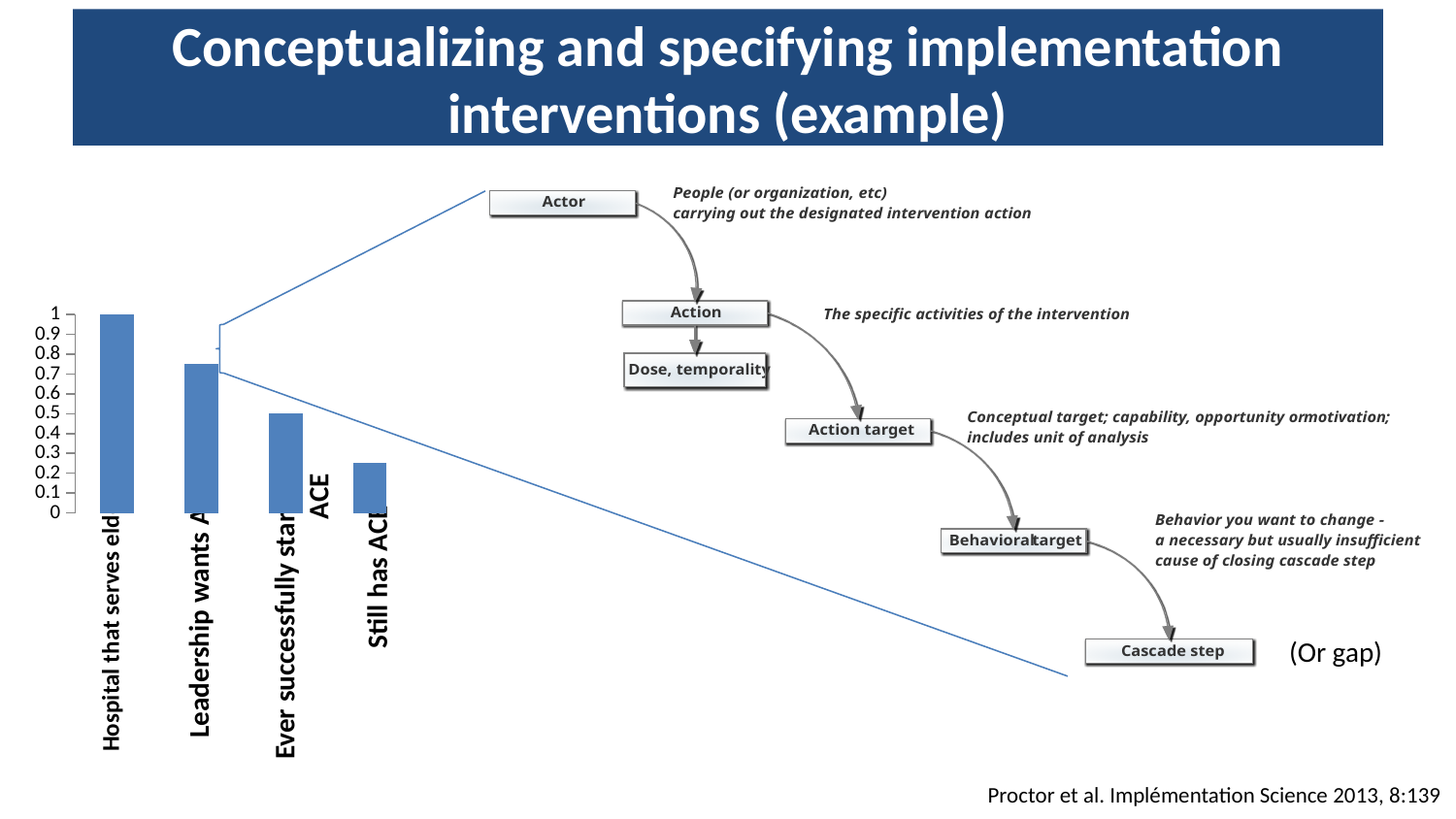
In the bar chart, what is the difference between the value of the first bar and the value of the third bar? 0.5 In the bar chart, which bar has the highest value? the first (leftmost) bar In the bar chart, what is the value of the first (leftmost) bar? 1 In the bar chart, which bar has the lowest value? Still has ACE What is the highest value shown on the vertical axis of the bar chart? 1 How many bars does the bar chart on the left of the slide have? 4 In the bar chart, which is larger: the first (leftmost) bar or the bar for 'Still has ACE'? the first (leftmost) bar In the bar chart, what is the value of the third bar from the left? 0.5 In the bar chart, is the value for 'Still has ACE' greater or less than 0.3? less In the bar chart, is the value of the second bar from the left greater or less than 0.7? greater In the bar chart, do the bar values rise or fall from left to right? fall What kind of chart is shown on the left of the slide? bar chart